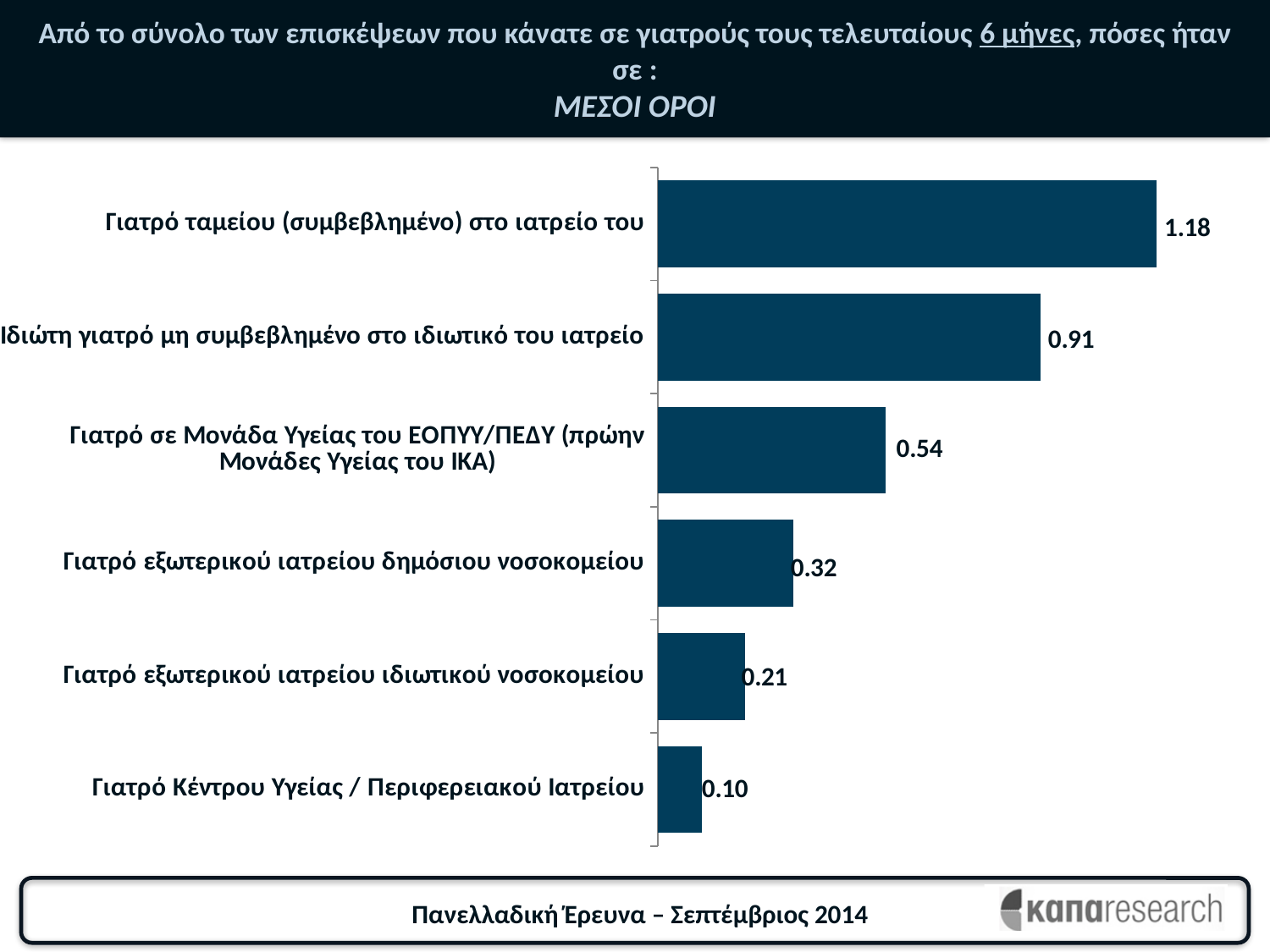
What is the value shown for 'Ιδιώτη γιατρό μη συμβεβλημένο στο ιδιωτικό του ιατρείο'? 0.91 What is the difference between the values for 'Γιατρό ταμείου (συμβεβλημένο) στο ιατρείο του' and 'Ιδιώτη γιατρό μη συμβεβλημένο στο ιδιωτικό του ιατρείο'? 0.27 Which category has the highest value? Γιατρό ταμείου (συμβεβλημένο) στο ιατρείο του What kind of chart is shown on the slide? Bar chart What is the value shown for 'Γιατρό σε Μονάδα Υγείας του ΕΟΠΥΥ/ΠΕΔΥ (πρώην Μονάδες Υγείας του ΙΚΑ)'? 0.54 What survey and date are shown in the footer of the slide? Πανελλαδική Έρευνα – Σεπτέμβριος 2014 Which is larger: the value for 'Γιατρό εξωτερικού ιατρείου δημόσιου νοσοκομείου' or for 'Γιατρό εξωτερικού ιατρείου ιδιωτικού νοσοκομείου'? Γιατρό εξωτερικού ιατρείου δημόσιου νοσοκομείου What is the value shown for 'Γιατρό Κέντρου Υγείας / Περιφερειακού Ιατρείου'? 0.10 Which category has the lowest value? Γιατρό Κέντρου Υγείας / Περιφερειακού Ιατρείου What is the difference between the values for 'Γιατρό εξωτερικού ιατρείου δημόσιου νοσοκομείου' and 'Γιατρό εξωτερικού ιατρείου ιδιωτικού νοσοκομείου'? 0.11 How many categories are shown in the chart? 6 What is the average number of visits for 'Γιατρό ταμείου (συμβεβλημένο) στο ιατρείο του'? 1.18